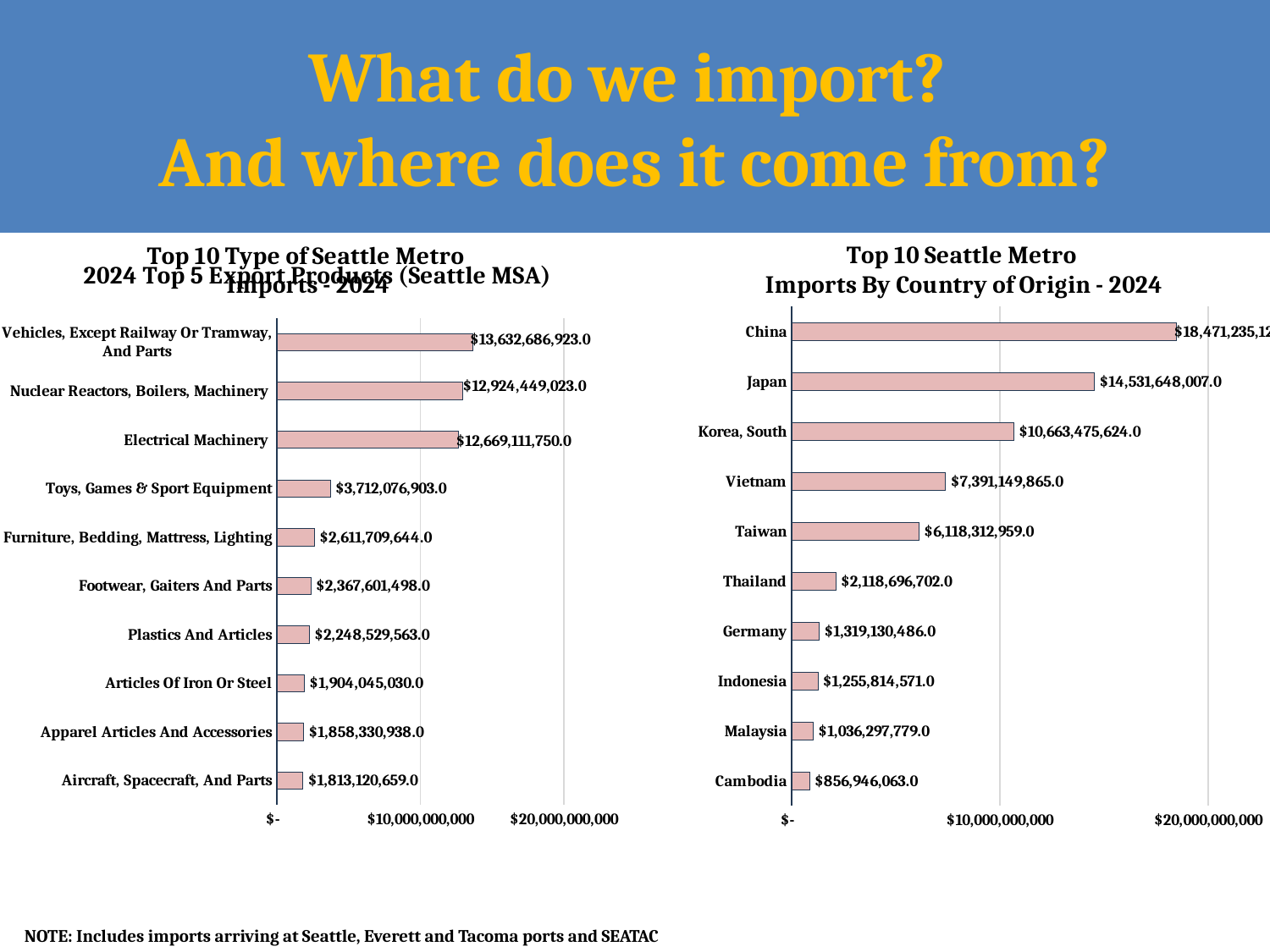
On the chart titled 'Top 10 Seattle Metro Imports By Country of Origin - 2024', is the value for China greater or less than $10,000,000,000? greater On the chart titled 'Top 10 Seattle Metro Imports By Country of Origin - 2024', what is the value for Cambodia? $856,946,063.0 On the left chart, which category has the lowest value? Aircraft, Spacecraft, And Parts On the left chart, how many categories are shown? 10 On the left chart, what is the value for Toys, Games & Sport Equipment? $3,712,076,903.0 On the left chart, what is the value for Electrical Machinery? $12,669,111,750.0 What kind of chart is the chart titled 'Top 10 Seattle Metro Imports By Country of Origin - 2024'? bar chart On the left chart, what is the difference between the values for Vehicles, Except Railway Or Tramway, And Parts and Nuclear Reactors, Boilers, Machinery? $708,237,900.0 On the chart titled 'Top 10 Seattle Metro Imports By Country of Origin - 2024', what is the difference between the values for Japan and Korea, South? $3,868,172,383.0 On the chart titled 'Top 10 Seattle Metro Imports By Country of Origin - 2024', what is the value for Vietnam? $7,391,149,865.0 On the chart titled 'Top 10 Seattle Metro Imports By Country of Origin - 2024', which country has the highest value? China On the left chart, which category has the highest value? Vehicles, Except Railway Or Tramway, And Parts